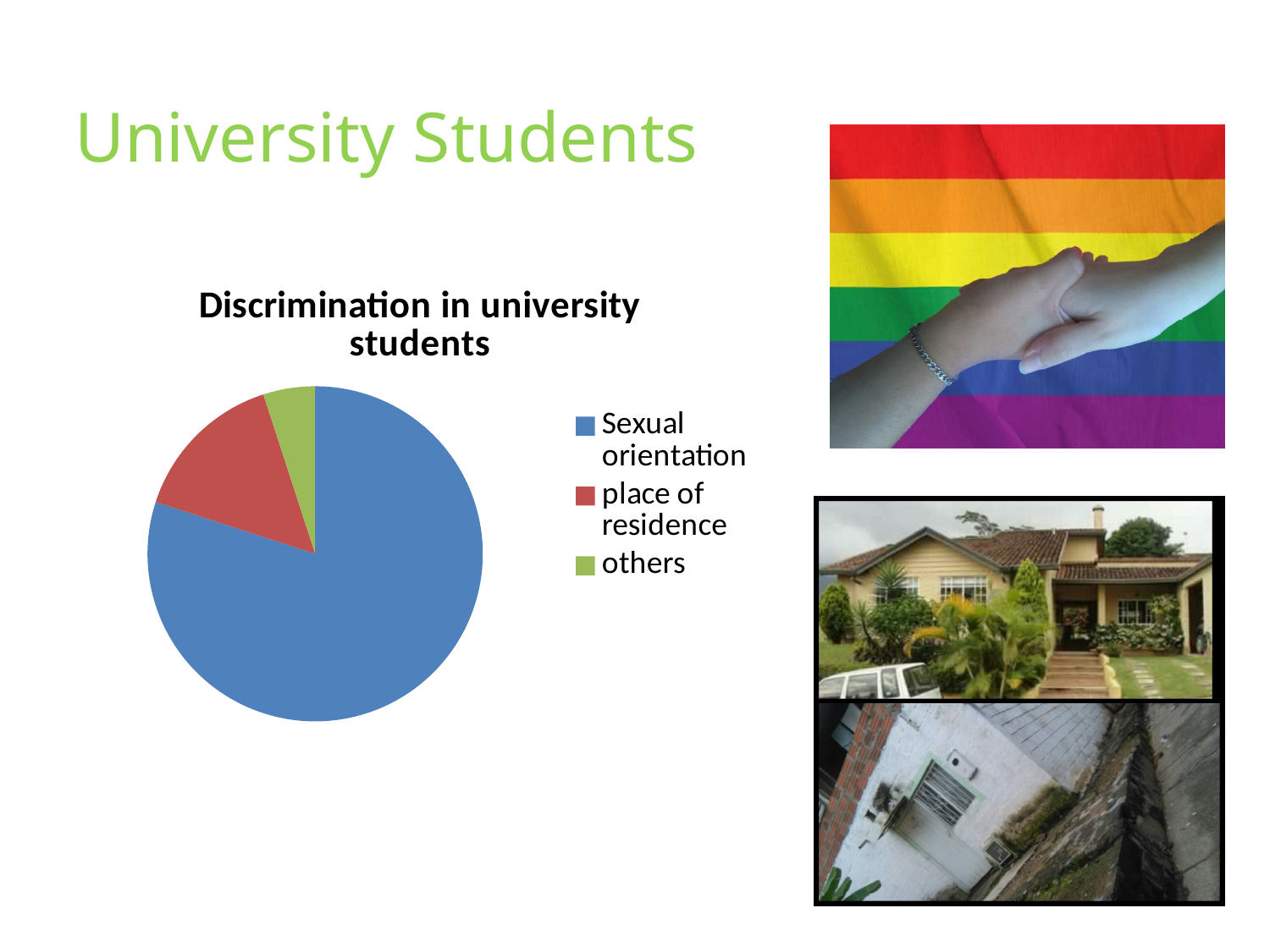
Does the 'Sexual orientation' slice take up more or less than half of the pie? more Which slice is larger: place of residence or others? place of residence Which slice is larger: Sexual orientation or place of residence? Sexual orientation What kind of chart is shown on the slide? pie chart Which colour represents the 'others' category in the pie chart? green What is the title of the chart? Discrimination in university students Which category has the largest slice of the pie? Sexual orientation How many categories does the pie chart show? 3 Which category has the smallest slice of the pie? others How many entries does the chart's legend list? 3